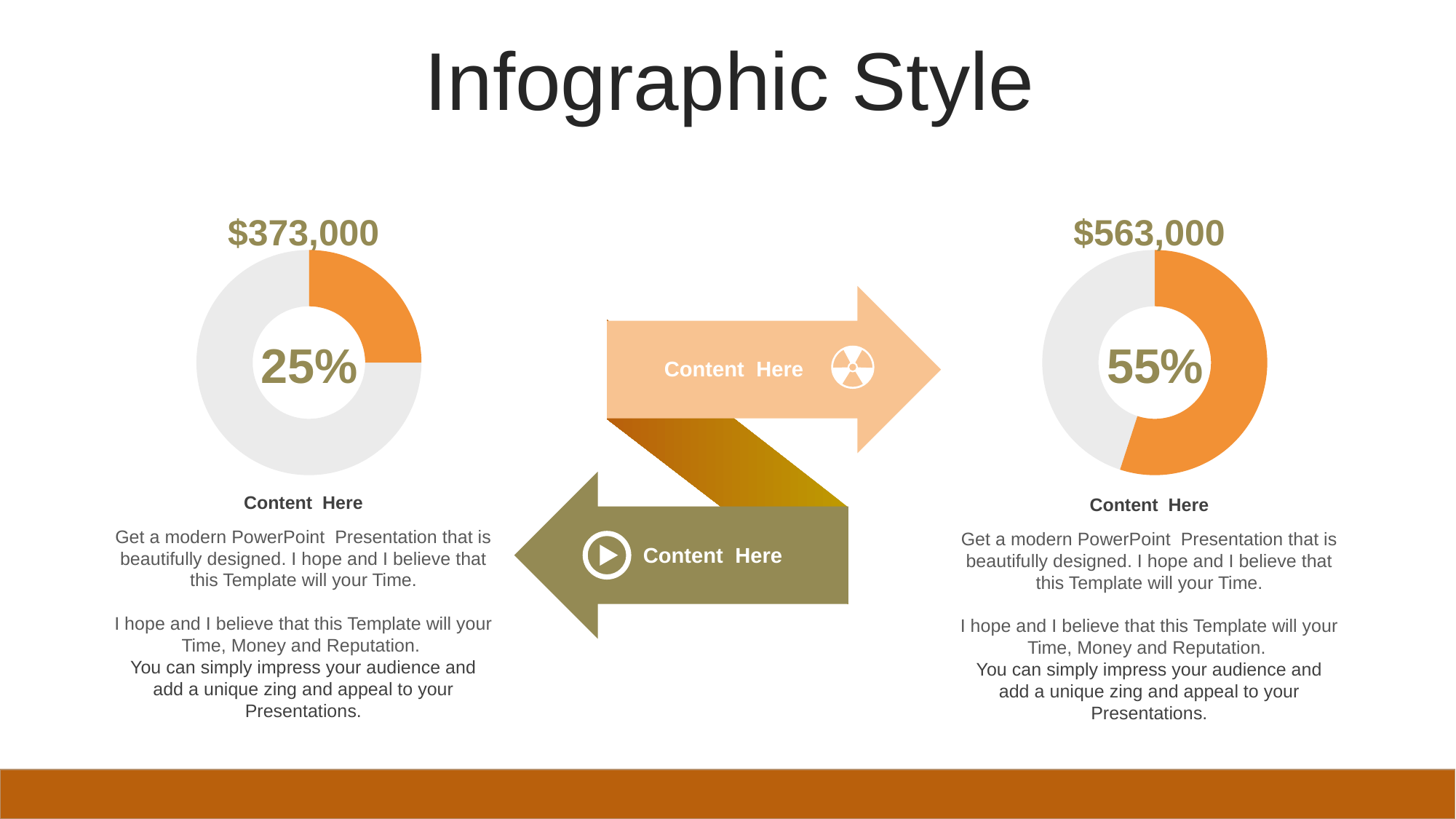
What percentage is shown in the centre of the right donut chart? 55% What percentage is shown in the centre of the left donut chart? 25% What share of the right donut chart is filled in orange? 55% What dollar amount is printed above the right donut chart? $563,000 How many donut charts are on the slide? 2 What is the difference between the dollar amounts above the right and left donut charts? $190,000 Which donut chart shows the larger percentage, the left one or the right one? the right one What kind of chart is used on the left side of the slide? donut chart What is the difference in percentage points between the right donut chart (55%) and the left donut chart (25%)? 30 percentage points What colour is the filled portion of the donut charts? orange What dollar amount is printed above the left donut chart? $373,000 Is the filled share of the left donut chart greater or less than 50%? less